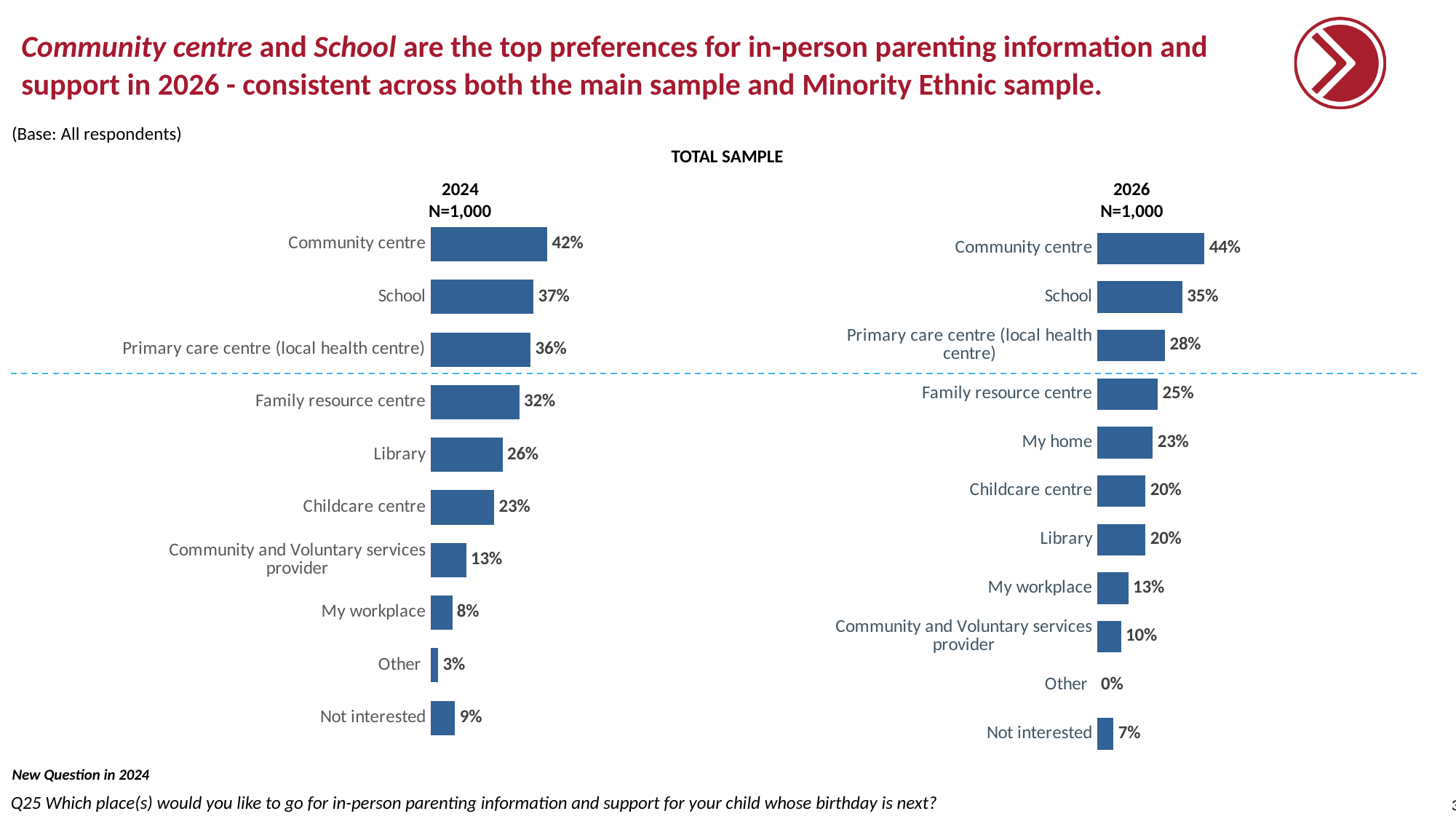
In the 2026 chart, what is the difference between Community centre and School? 9% In the 2024 chart, which category has the lowest value? Other In the 2026 chart, what is the value for Primary care centre (local health centre)? 28% In the 2026 chart, which category has the lowest value? Other In the 2026 chart, what is the value for My home? 23% In the 2024 chart, what is the value for Community centre? 42% What kind of chart is the 2024 chart? Bar chart In the 2024 chart, which category has the highest value? Community centre How many categories are shown in the 2026 chart? 11 What is the sample size (N) shown above the 2026 chart? N=1,000 In the 2024 chart, what is the difference between Library and Childcare centre? 3% In the 2024 chart, which is larger: Family resource centre or Library? Family resource centre